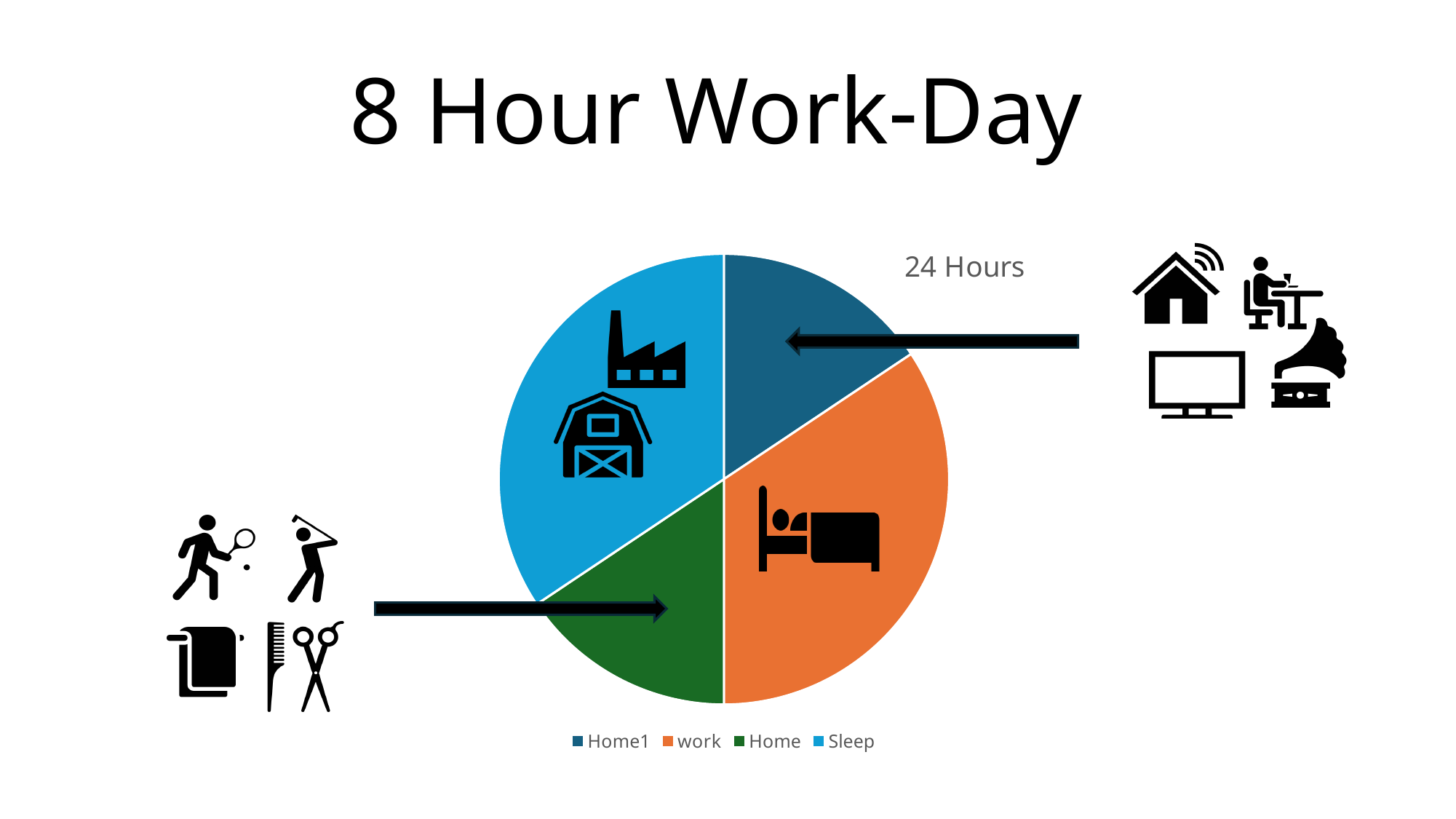
Which slice is larger in the pie chart, work or Home1? work Which slice is larger in the pie chart, Sleep or Home? Sleep How many slices does the pie chart have? 4 How many entries does the legend of the pie chart list? 4 What kind of chart is shown on the slide? pie chart Which slice is larger in the pie chart, work or Home? work What colour is the work slice in the pie chart? orange What text label appears next to the pie chart at its upper right? 24 Hours